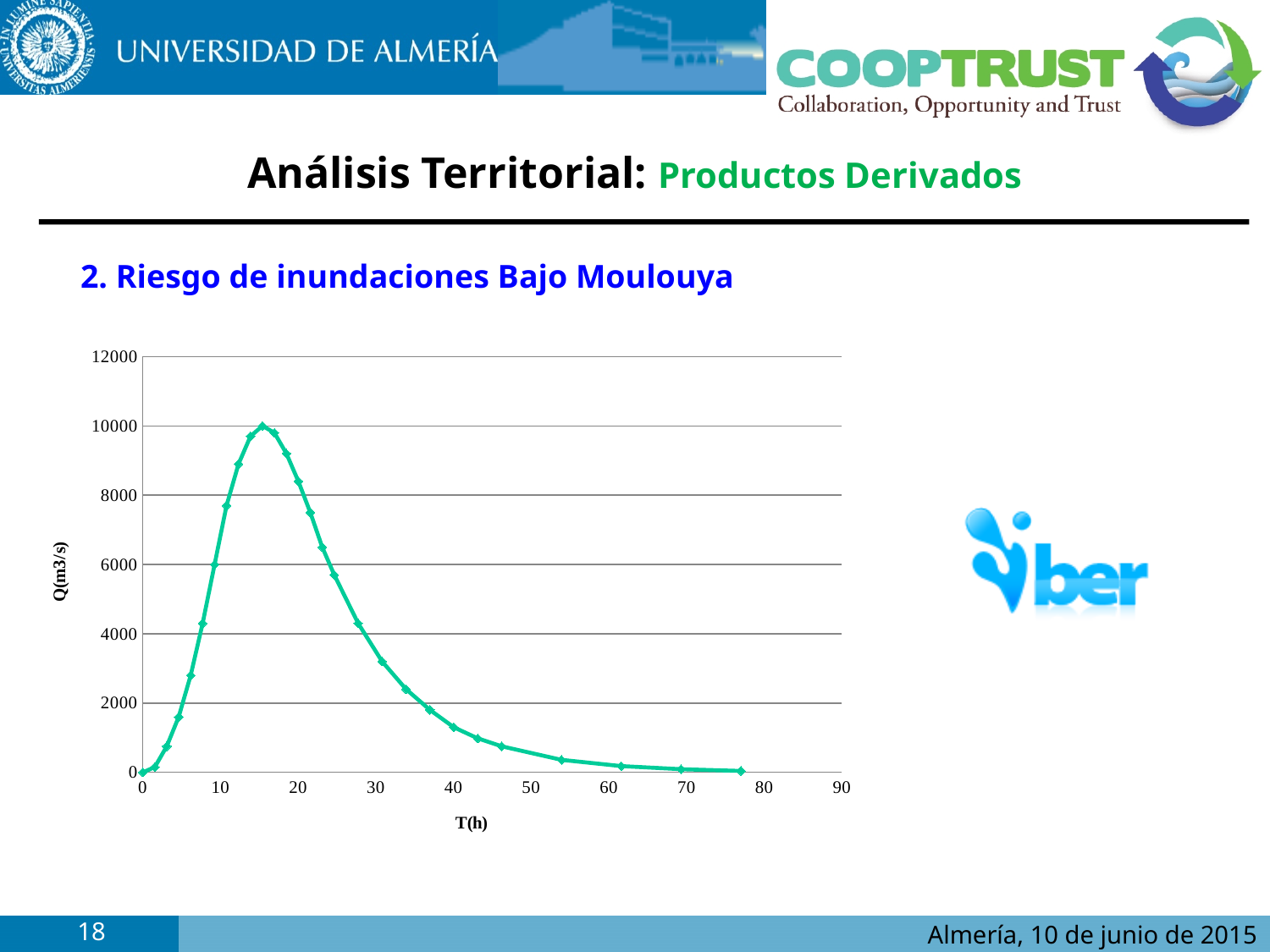
Is the value of Q at T = 40 greater or less than 2000? less Do the values rise or fall along the x axis between T = 20 and T = 70? fall Is the value of Q at T = 30 greater or less than 4000? less Is the value of Q at T = 10 greater or less than 6000? greater What is the label of the y axis of the chart? Q(m3/s) Do the values rise or fall along the x axis between T = 0 and T = 15? rise What is the label of the x axis of the chart? T(h) Which is larger, the value of Q at T = 20 or at T = 40? T = 20 What kind of chart is shown on the slide? line chart